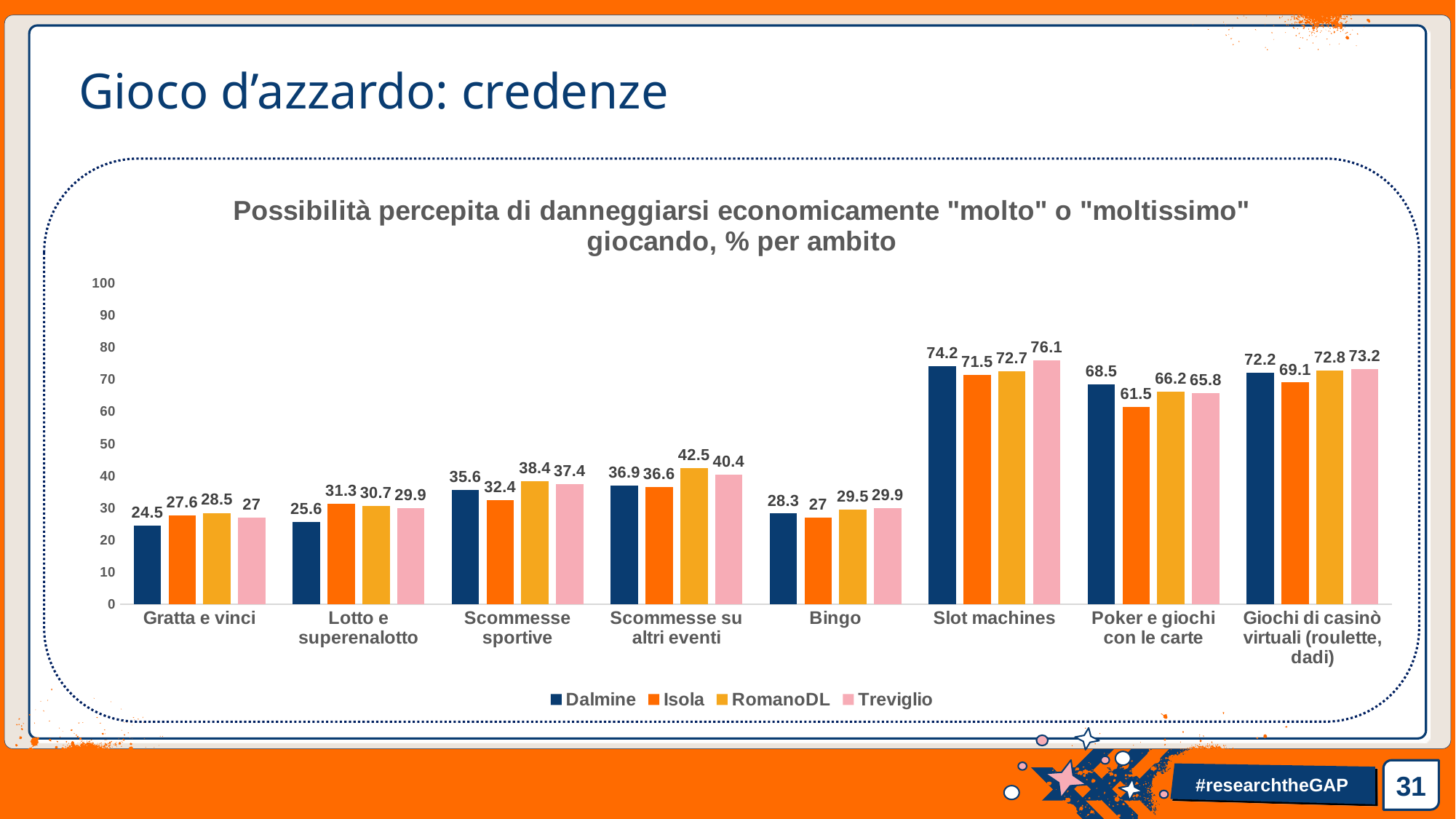
How many series does the legend list? 4 Which series is shown in pink in the legend? Treviglio Is the Treviglio value for Slot machines greater or less than 70? greater Which series has the highest value in the Slot machines category? Treviglio Which is larger: the RomanoDL value for Scommesse sportive or the RomanoDL value for Scommesse su altri eventi? Scommesse su altri eventi What kind of chart is shown on the slide? bar chart What is the difference between the Dalmine and Isola values in the Poker e giochi con le carte category? 7 What is the value for Treviglio in the Scommesse su altri eventi category? 40.4 Which series has the lowest value in the Gratta e vinci category? Dalmine How many categories are shown on the x axis? 8 What is the value for Isola in the Poker e giochi con le carte category? 61.5 What is the value for Dalmine in the Slot machines category? 74.2